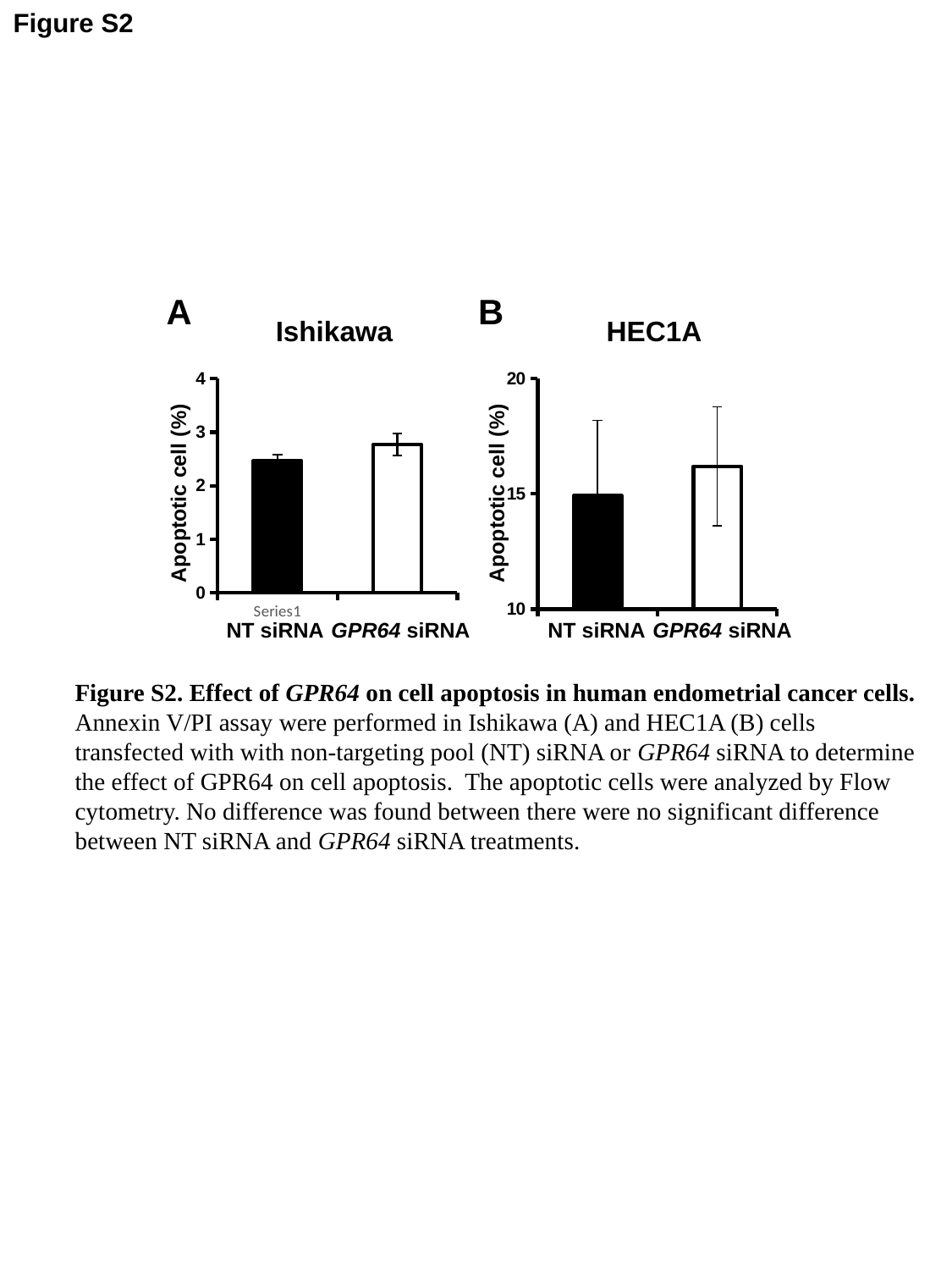
What is the maximum value shown on the y-axis of the Ishikawa chart (A)? 4 What kind of chart is the Ishikawa chart (A)? bar chart In the HEC1A chart (B), is the value for GPR64 siRNA greater or less than 15? greater In the Ishikawa chart (A), which bar is taller, NT siRNA or GPR64 siRNA? GPR64 siRNA In the Ishikawa chart (A), is the value for NT siRNA greater or less than 2? greater In the Ishikawa chart (A), which category has the lowest value? NT siRNA In the HEC1A chart (B), which bar is taller, NT siRNA or GPR64 siRNA? GPR64 siRNA In the HEC1A chart (B), is the value for NT siRNA greater or less than 20? less How many bars are plotted in the HEC1A chart (B)? 2 In the HEC1A chart (B), which category has the highest value? GPR64 siRNA What is the y-axis label of the HEC1A chart (B)? Apoptotic cell (%)